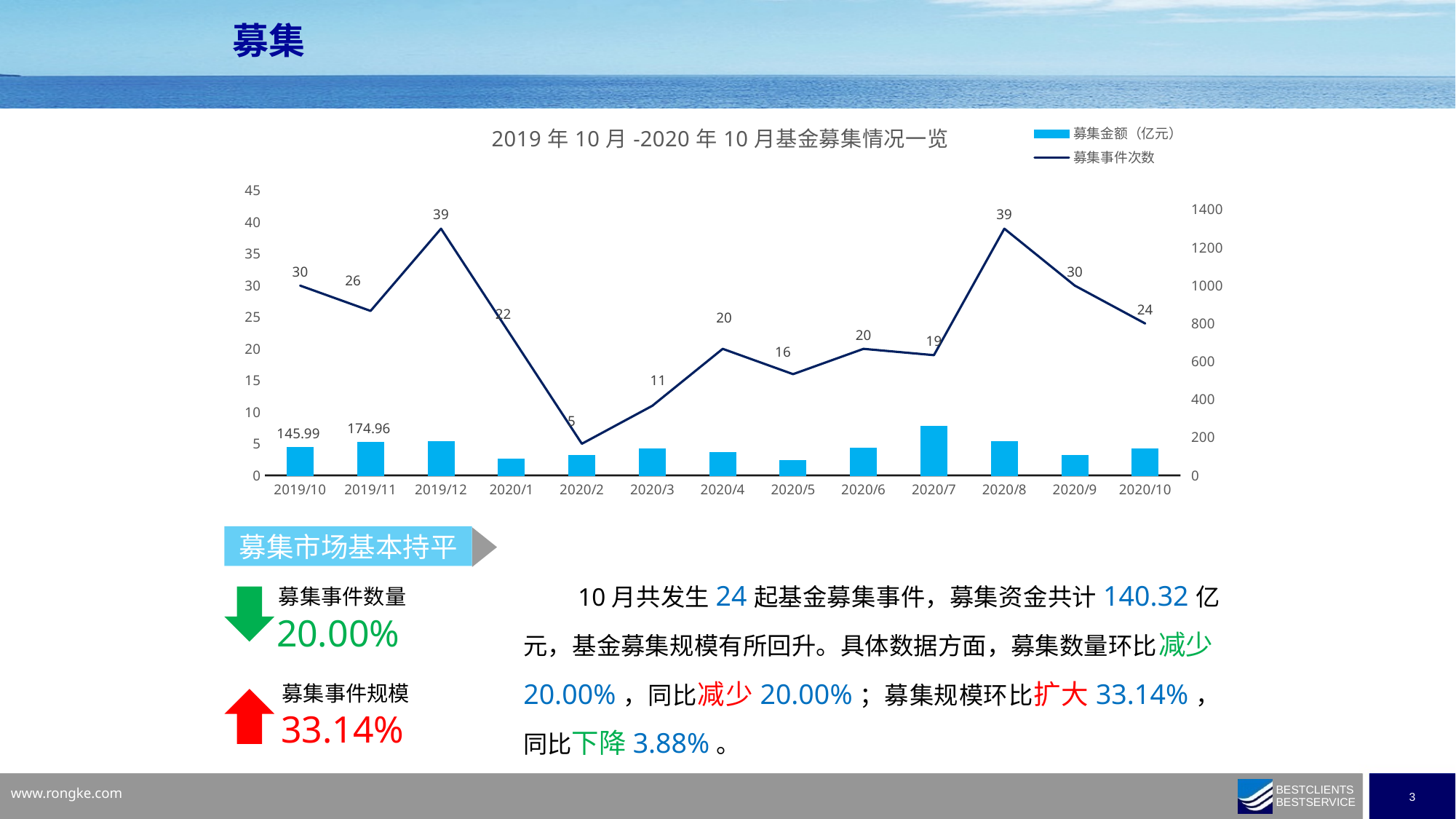
How many months are shown on the x axis of the chart? 13 Which month has the lowest number of fundraising events (募集事件次数)? 2020/2 What is the difference in fundraising amount (募集金额) between 2019/11 and 2019/10? 28.97 What is the number of fundraising events (募集事件次数) for 2019/12? 39 How many series does the chart legend list? 2 How many more fundraising events were there in 2019/12 than in 2020/2? 34 Which month has the tallest fundraising amount (募集金额) bar? 2020/7 Is the fundraising amount (募集金额) bar for 2020/5 greater or less than 200? less What is the fundraising amount (募集金额) for 2019/11? 174.96 What is the number of fundraising events (募集事件次数) for 2020/2? 5 What kind of chart is shown on the slide? Combination bar and line chart Which month had more fundraising events, 2020/4 or 2020/5? 2020/4